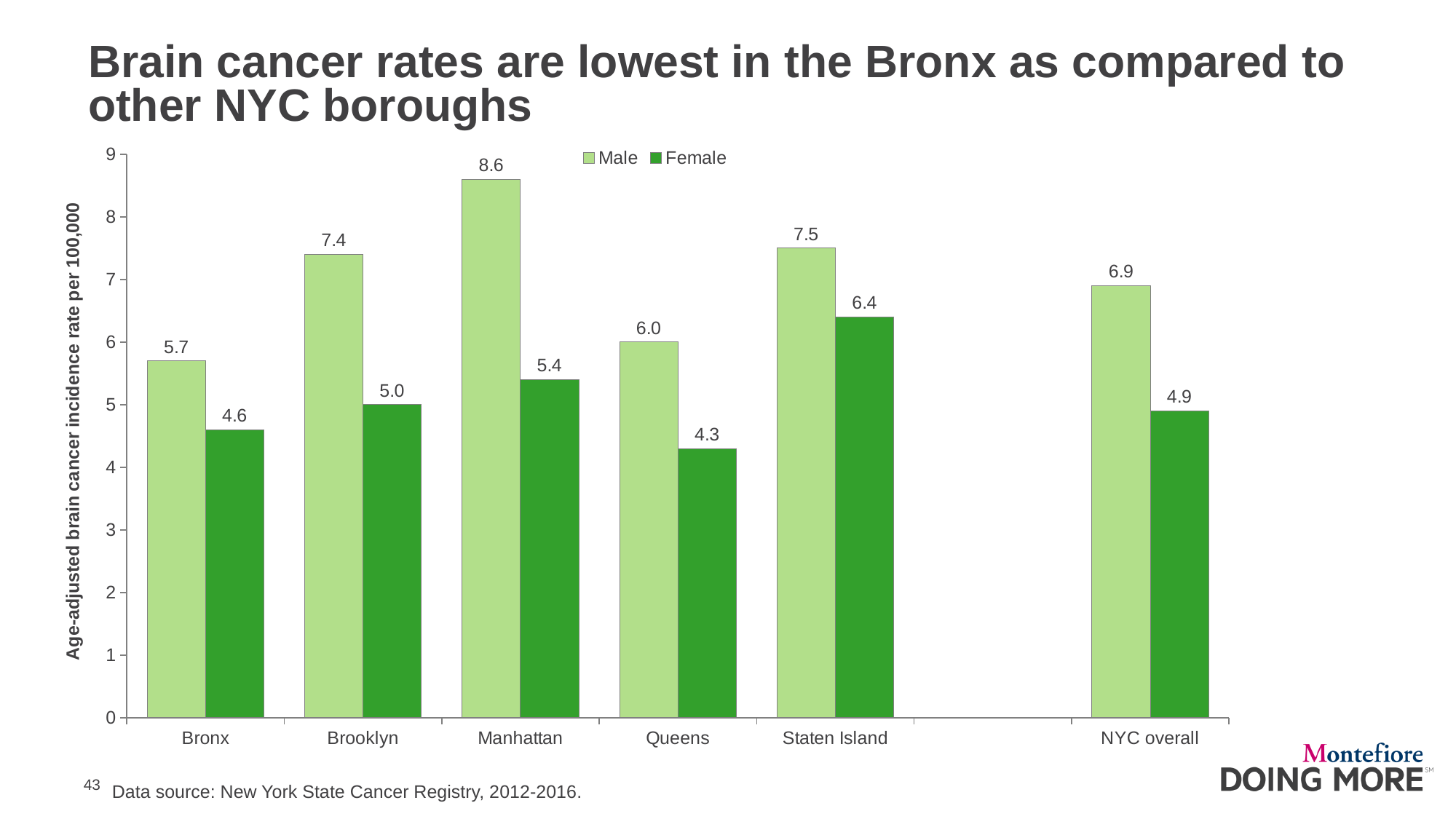
Which borough has the highest male brain cancer incidence rate? Manhattan What is the female rate for NYC overall? 4.9 What is the male brain cancer incidence rate for the Bronx? 5.7 Which is larger, the male rate for Brooklyn or the male rate for Staten Island? Staten Island Is the male rate for Queens greater or less than 5? greater What is the label of the y axis? Age-adjusted brain cancer incidence rate per 100,000 How many series does the legend list? 2 What is the female brain cancer incidence rate for Staten Island? 6.4 How many categories are shown on the x axis? 6 What kind of chart is shown on the slide? Bar chart Which category has the lowest female brain cancer incidence rate? Queens What is the difference between the male and female rates in Manhattan? 3.2